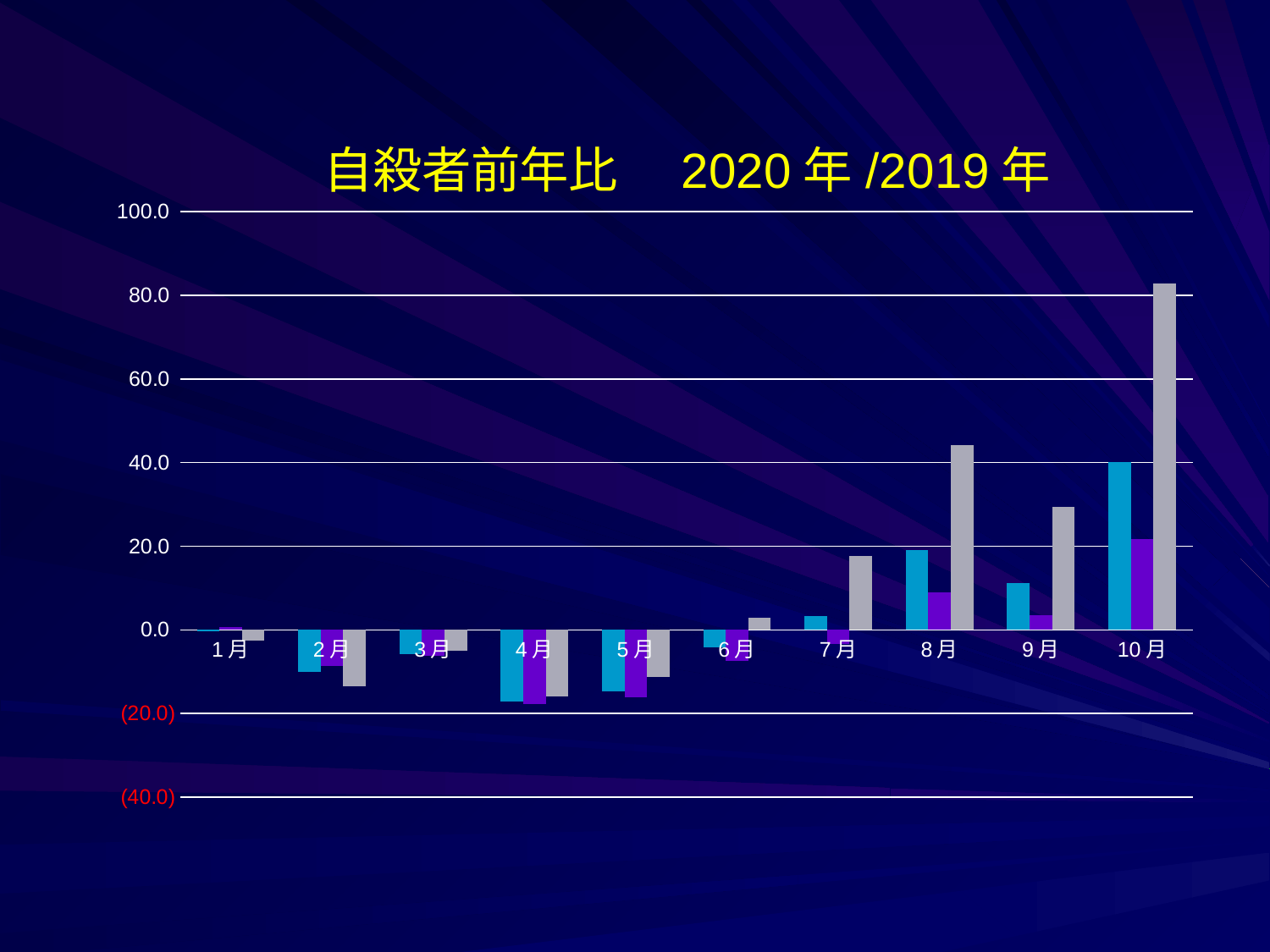
Which is larger, the gray bar for 8月 or the gray bar for 9月? 8月 Which is larger, the cyan bar for 10月 or the cyan bar for 8月? 10月 What is the title of the chart? 自殺者前年比 2020年/2019年 How many months are shown on the x axis of the chart? 10 Is the value of the gray bar for 8月 greater or less than 40.0? greater Is the value of the gray bar for 9月 greater or less than 20.0? greater Is the value of the cyan bar for 4月 greater or less than 0.0? less What kind of chart is shown on the slide? bar chart Do the gray bars rise or fall from 6月 to 10月? rise Which month has the tallest bar in the chart? 10月